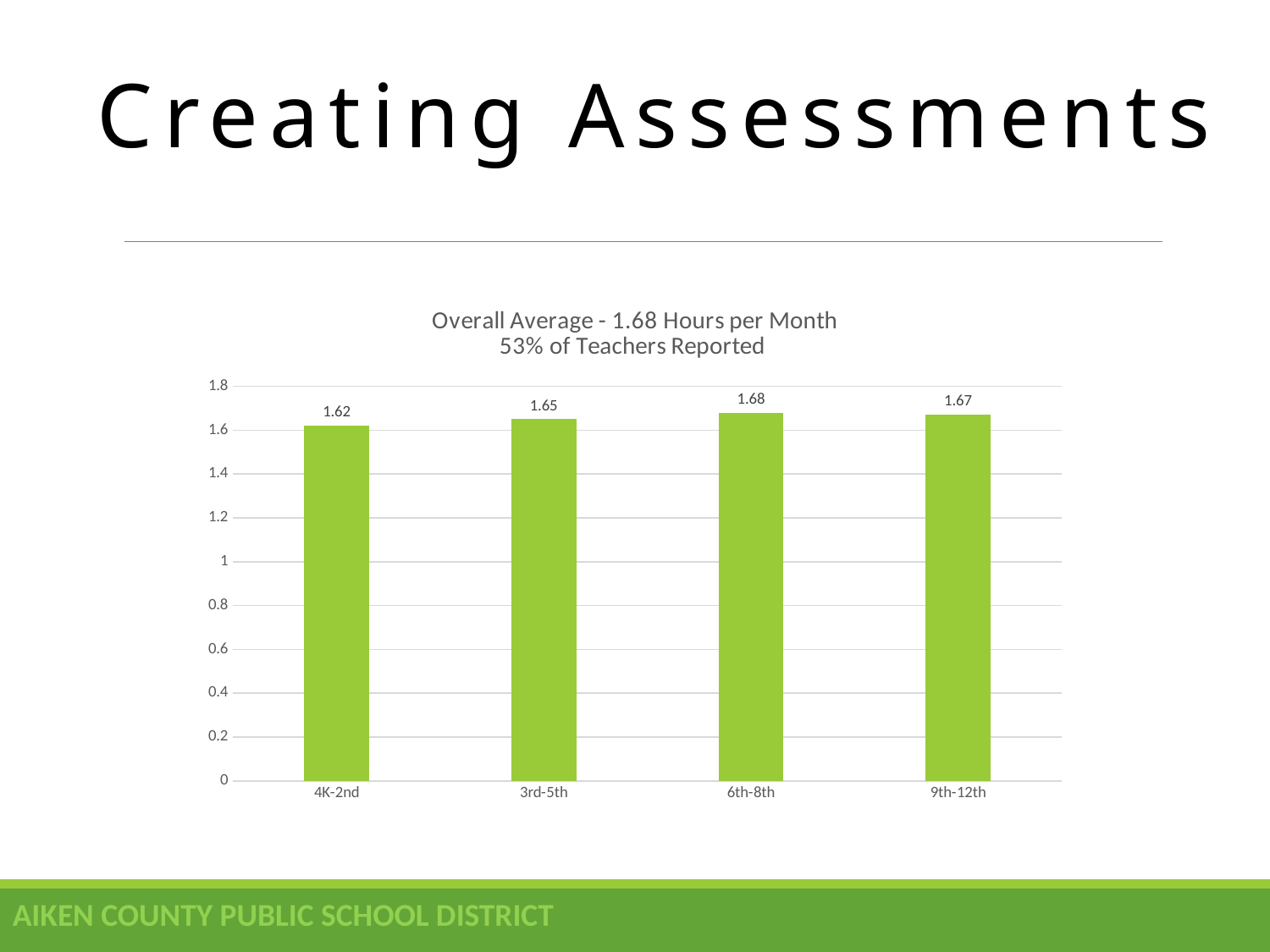
What is the difference between the values for 9th-12th and 3rd-5th? 0.02 What is the value for 9th-12th? 1.67 What percentage of teachers reported, according to the chart title? 53% Which grade band has the highest value? 6th-8th What is the overall average stated in the chart title? 1.68 Hours per Month What is the value for 4K-2nd? 1.62 What is the value for 6th-8th? 1.68 How many grade bands are shown on the chart? 4 What kind of chart is shown on the slide? Bar chart What is the value for 3rd-5th? 1.65 Which grade band has the lowest value? 4K-2nd What is the difference between the values for 6th-8th and 4K-2nd? 0.06